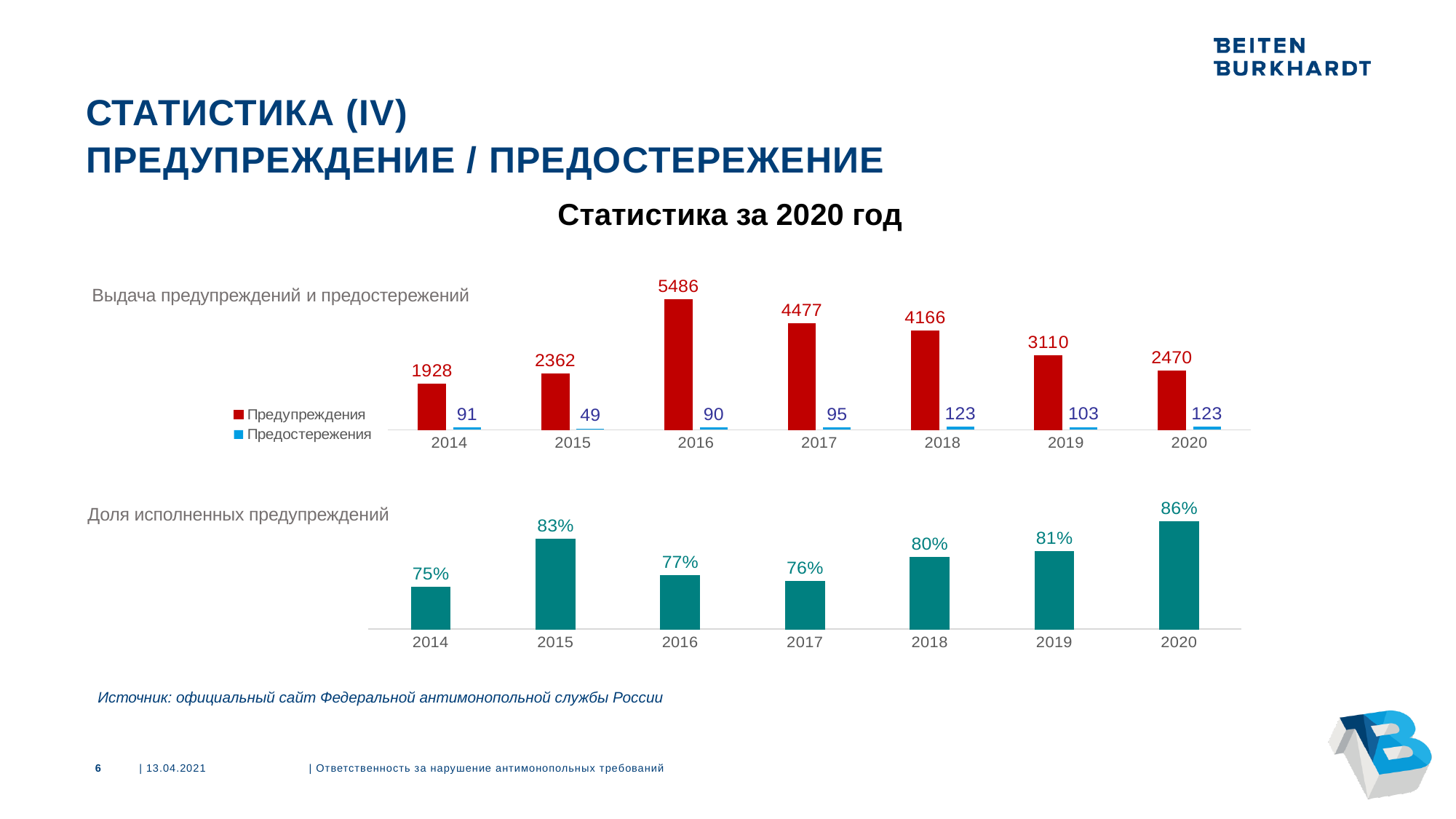
In the bottom chart (Доля исполненных предупреждений), what is the value for 2018? 80% In the top chart (Выдача предупреждений и предостережений), which year has the highest value for Предупреждения? 2016 In the bottom chart (Доля исполненных предупреждений), which year has the lowest value? 2014 In the top chart (Выдача предупреждений и предостережений), what is the value for Предупреждения in 2016? 5486 In the bottom chart (Доля исполненных предупреждений), which year has the highest value? 2020 In the top chart (Выдача предупреждений и предостережений), what is the value for Предостережения in 2015? 49 In the top chart (Выдача предупреждений и предостережений), what is the difference between the Предупреждения values for 2017 and 2018? 311 In the top chart (Выдача предупреждений и предостережений), how many series does the legend list? 2 In the top chart (Выдача предупреждений и предостережений), which is larger: Предупреждения in 2019 or in 2020? 2019 In the top chart (Выдача предупреждений и предостережений), which year has the lowest value for Предостережения? 2015 In the bottom chart (Доля исполненных предупреждений), how many years are shown on the x axis? 7 What kind of chart is the bottom chart (Доля исполненных предупреждений)? Bar chart